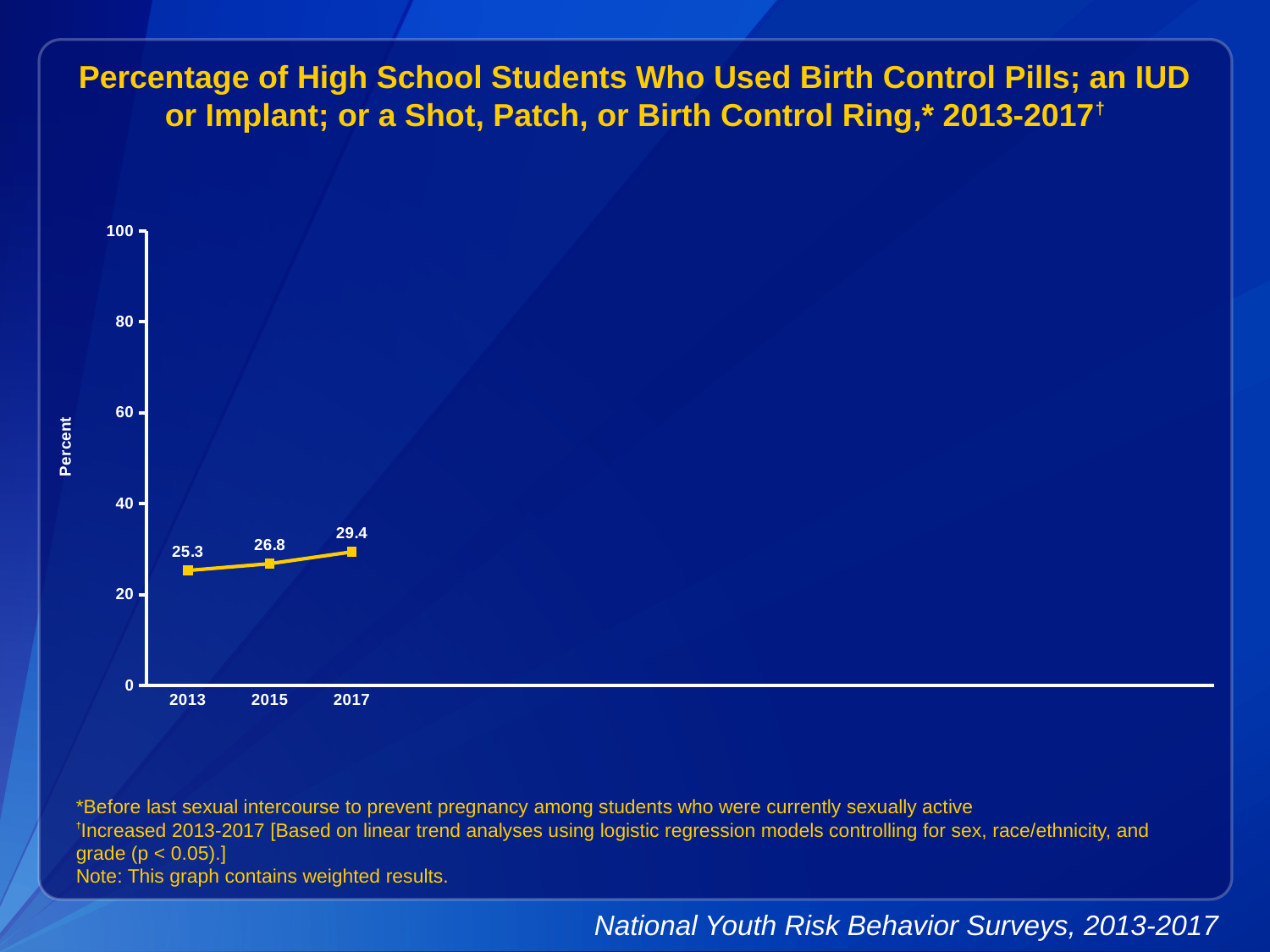
What is the difference between the values for 2017 and 2013? 4.1 How many data points are plotted on the chart? 3 Which year has the lowest value? 2013 What is the value for 2015? 26.8 What is the value for 2013? 25.3 What is the difference between the values for 2015 and 2013? 1.5 Do the values rise or fall from 2013 to 2017? rise What is the value for 2017? 29.4 Which year has the highest value? 2017 Which is larger, the value for 2015 or the value for 2017? 2017 Is the value for 2017 greater or less than 40? less What kind of chart is shown on the slide? line chart